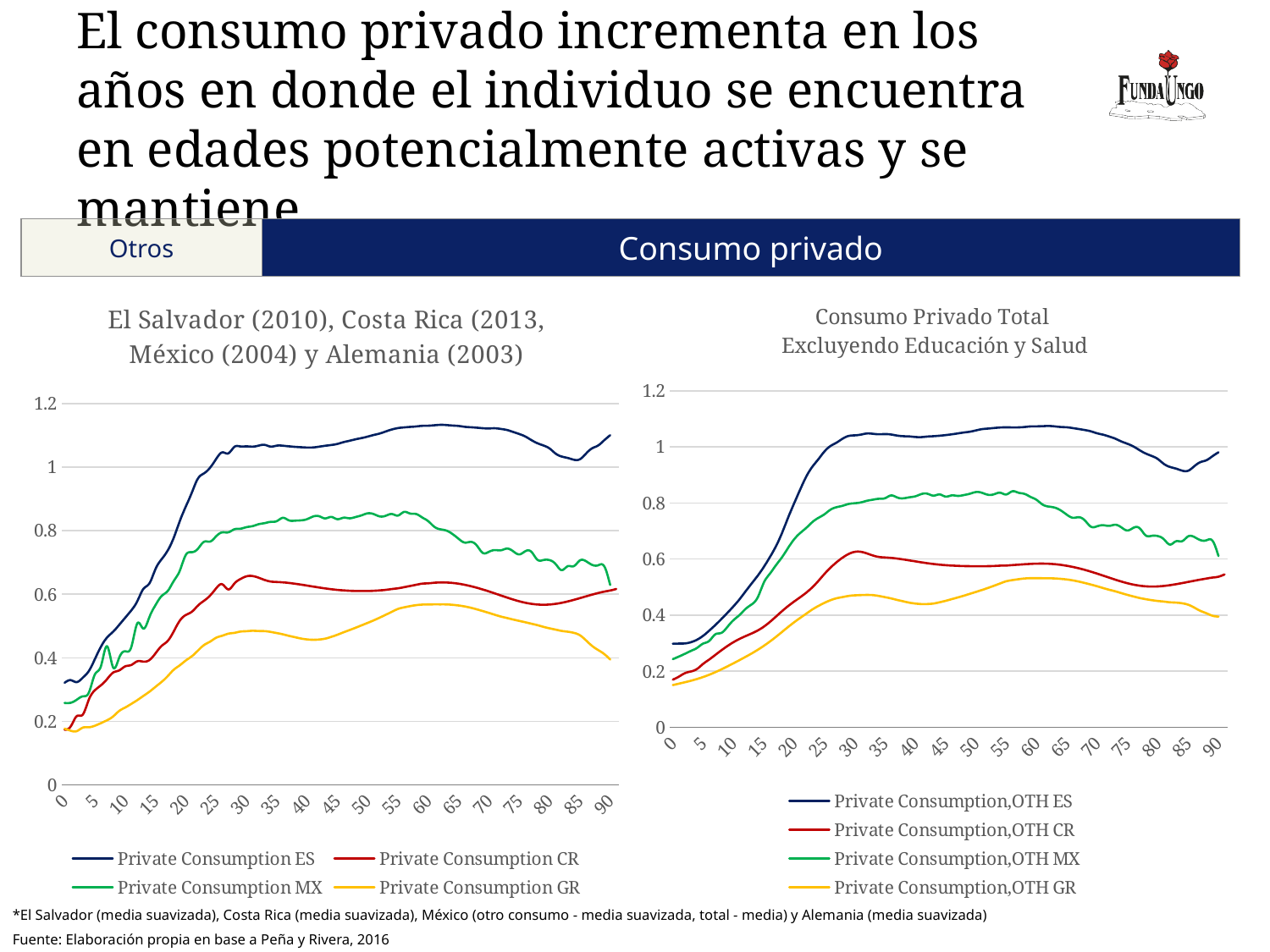
In the left chart, does Private Consumption ES rise or fall between ages 0 and 25? rise In the right chart "Consumo Privado Total Excluyendo Educación y Salud", which series stays lowest across the ages? Private Consumption,OTH GR In the left chart, is the value of Private Consumption ES at age 60 greater or less than 1? greater In the left chart, is the value of Private Consumption GR at age 10 greater or less than 0.4? less In the right chart, does Private Consumption,OTH GR rise or fall between ages 60 and 90? fall In the right chart, is the value of Private Consumption,OTH MX at age 50 greater or less than 0.8? greater In the right chart, at age 30, which is larger: Private Consumption,OTH MX or Private Consumption,OTH CR? Private Consumption,OTH MX What kind of chart is the left chart titled "El Salvador (2010), Costa Rica (2013, México (2004) y Alemania (2003)"? line chart In the left chart, at age 60, which is larger: Private Consumption ES or Private Consumption GR? Private Consumption ES How many series does the legend of the right chart "Consumo Privado Total Excluyendo Educación y Salud" list? 4 In the left chart, which series reaches the highest values? Private Consumption ES